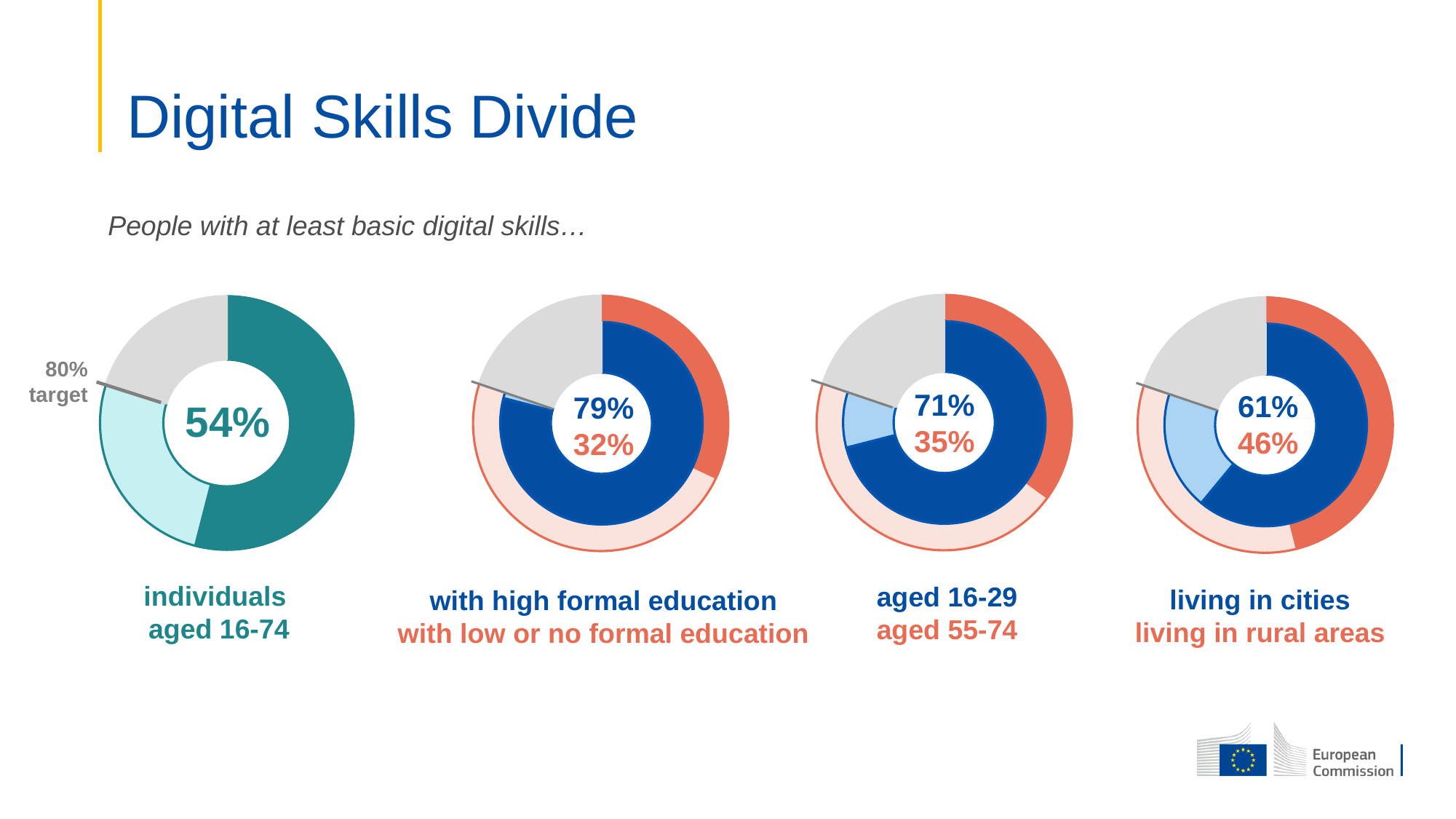
What percentage of people with low or no formal education have at least basic digital skills? 32% What percentage of individuals aged 16-74 have at least basic digital skills? 54% What is the difference in percentage points between people living in cities and people living in rural areas? 15 Across all the groups shown, which group has the highest share of people with at least basic digital skills? with high formal education Which group has a higher share of people with at least basic digital skills: those aged 16-29 or those aged 55-74? aged 16-29 What is the difference in percentage points between people with high formal education and people with low or no formal education? 47 What percentage of people aged 55-74 have at least basic digital skills? 35% What percentage of people living in rural areas have at least basic digital skills? 46% What kind of chart is used to show the digital skills shares on this slide? Donut (pie) chart What target percentage is marked on the donut charts? 80% What percentage of people with high formal education have at least basic digital skills? 79% What percentage of people aged 16-29 have at least basic digital skills? 71%